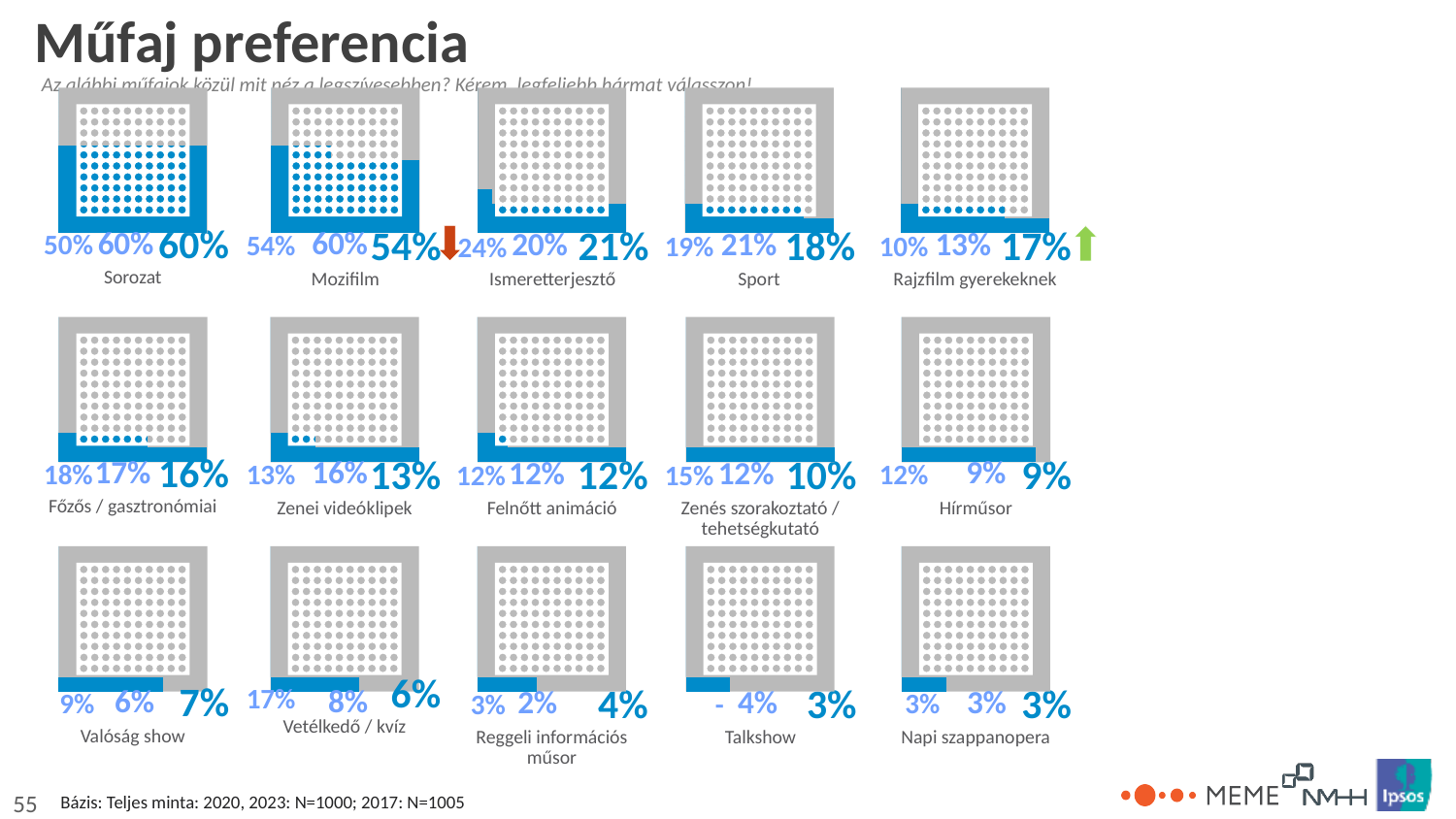
Which genre is marked with a green upward arrow? Rajzfilm gyerekeknek What is the bold (largest-font) value shown for Vetélkedő / kvíz? 6% Which has the larger bold value, Sport or Ismeretterjesztő? Ismeretterjesztő What is the bold (largest-font) value shown for Rajzfilm gyerekeknek? 17% Which genre has the highest bold (largest-font) value on the slide? Sorozat What is the bold (largest-font) value shown for Sorozat? 60% Do the three values for Rajzfilm gyerekeknek rise or fall from left to right? rise What is the difference between the bold values for Sorozat and Mozifilm? 6 percentage points Which genre is marked with a red downward arrow? Mozifilm What is the first (leftmost) value shown for Ismeretterjesztő? 24% How many genre categories are shown on the slide? 15 Which has the larger bold value, Főzős / gasztronómiai or Zenei videóklipek? Főzős / gasztronómiai